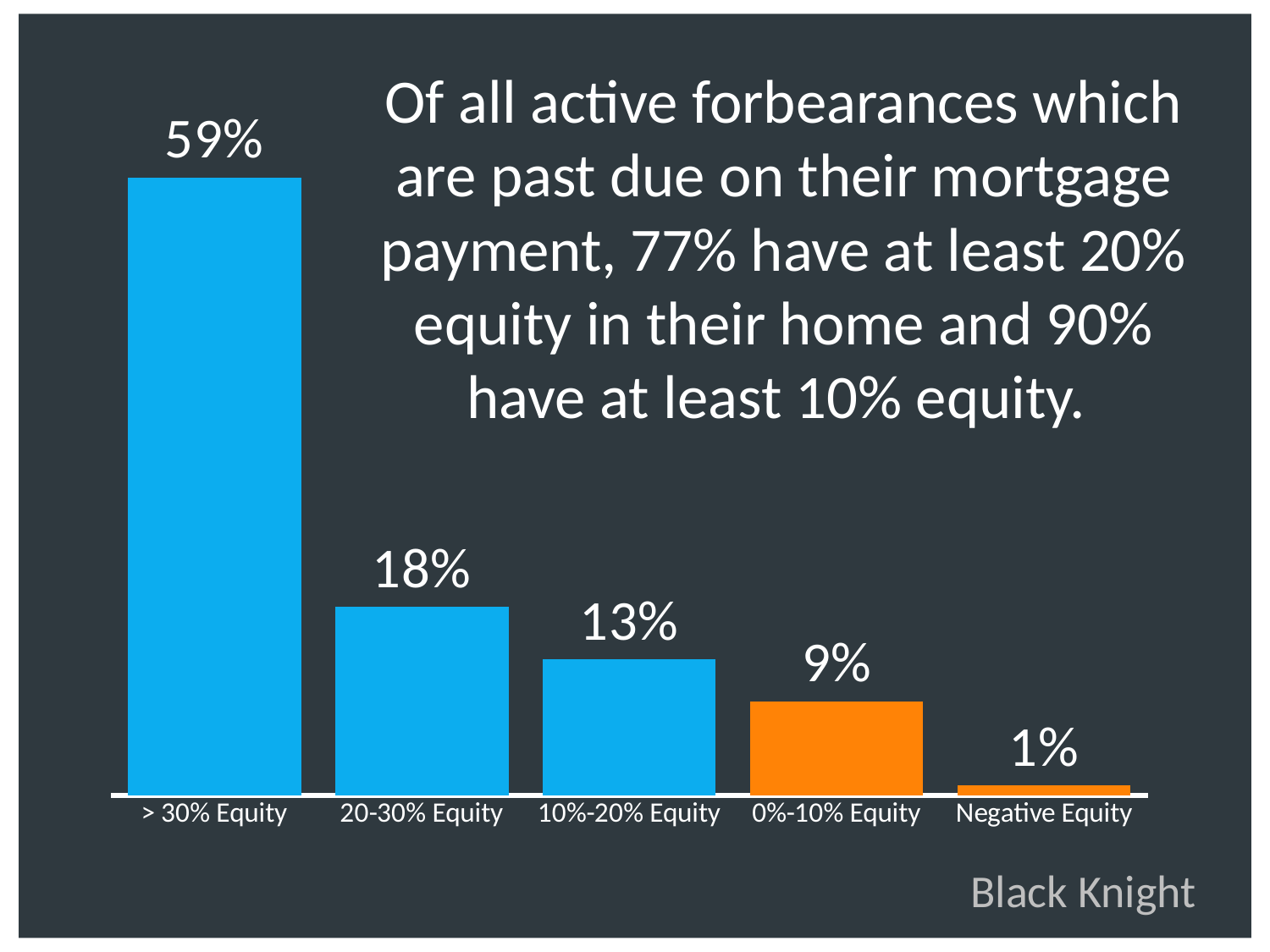
What kind of chart is shown on the slide? Bar chart What is the value for Negative Equity? 1% What is the difference between the values for > 30% Equity and 20-30% Equity? 41% What is the value for 10%-20% Equity? 13% Which category has the lowest value? Negative Equity What is the difference between the values for 0%-10% Equity and Negative Equity? 8% Which category has the highest value? > 30% Equity How many categories are shown in the chart? 5 Which is larger, the value for 10%-20% Equity or the value for 0%-10% Equity? 10%-20% Equity Do the values rise or fall from left to right across the categories? Fall What is the value for > 30% Equity? 59% What is the value for 20-30% Equity? 18%